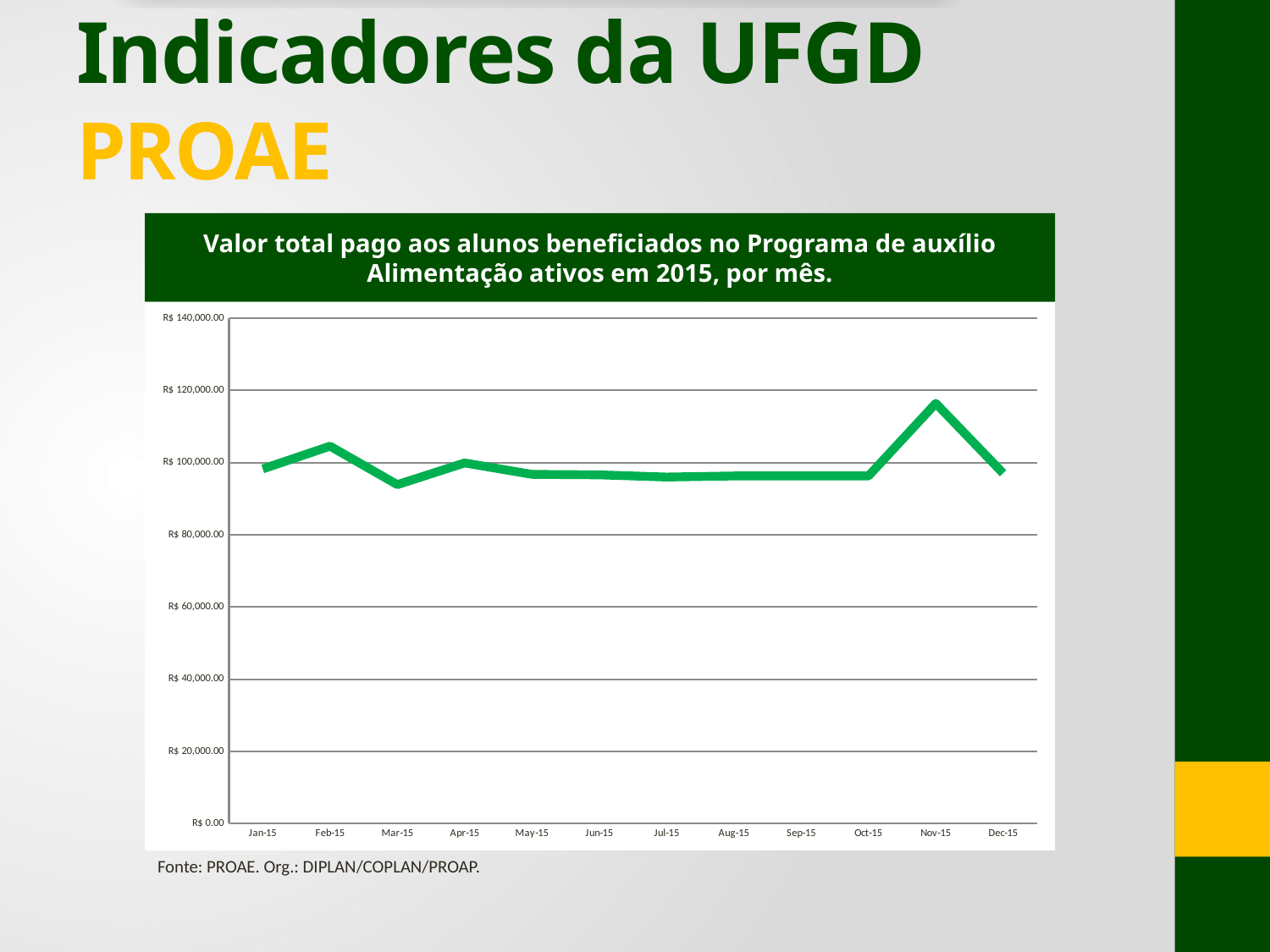
Is the value for Nov-15 greater or less than R$ 100,000.00? greater Does the value rise or fall from Oct-15 to Nov-15? rise Which month has the highest value in the chart? Nov-15 How many months are plotted along the x axis of the chart? 12 Which is larger, the value for Feb-15 or the value for Mar-15? Feb-15 Is the value for Jul-15 greater or less than R$ 100,000.00? less Which is larger, the value for Nov-15 or the value for Feb-15? Nov-15 What kind of chart is shown on the slide? line chart Is the value for Nov-15 greater or less than R$ 120,000.00? less What is the highest tick value shown on the y axis of the chart? R$ 140,000.00